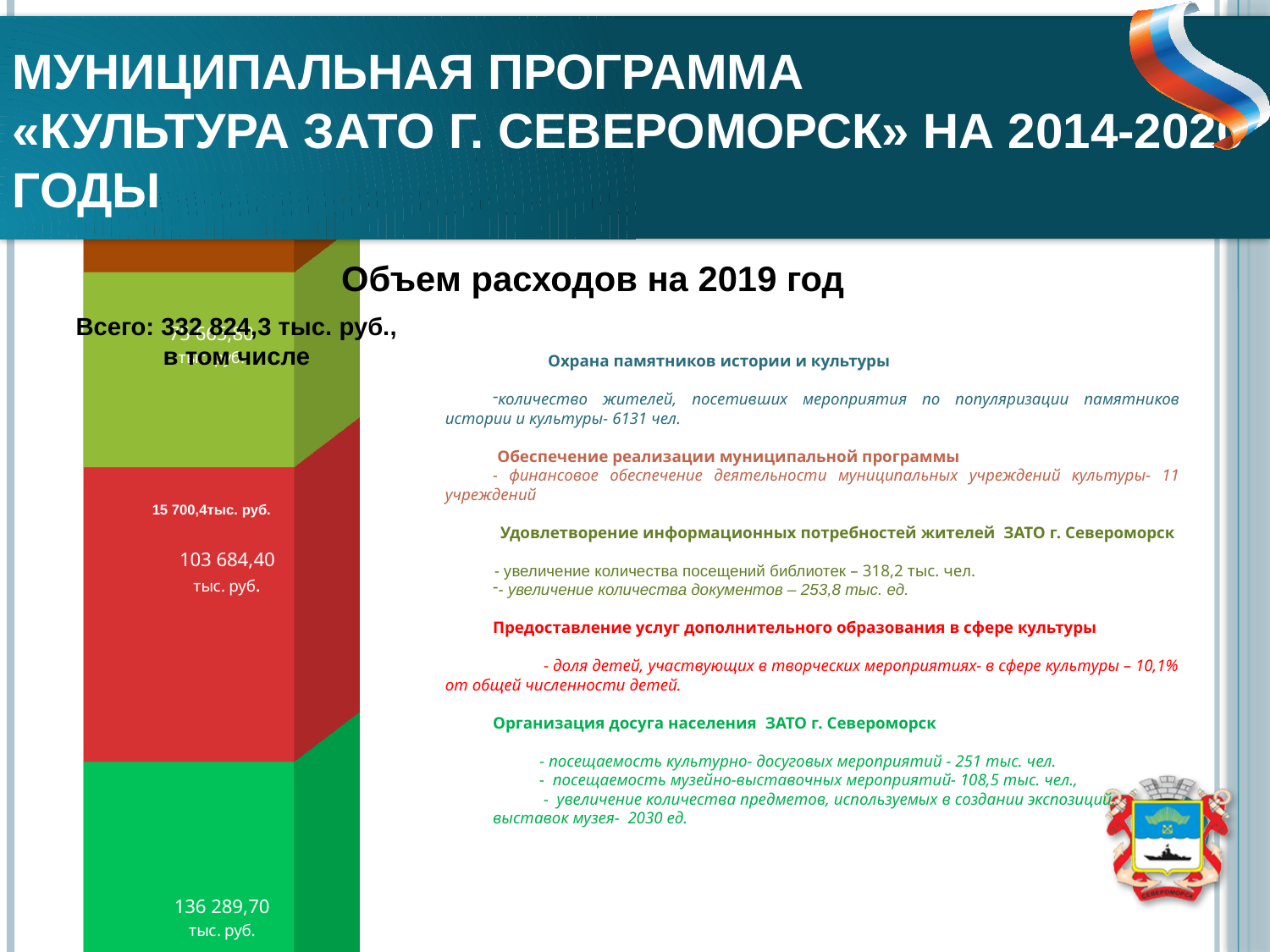
Which segment of the stacked bar is larger: the bottom green segment or the red segment? the bottom green segment What total amount is stated above the chart for 2019? 332 824,3 тыс. руб. How many coloured segments are visible in the stacked bar? 4 Which segment of the stacked bar is the largest? the bottom green segment (136 289,70 тыс. руб.) What is the difference between the bottom green segment (136 289,70) and the red segment (103 684,40) of the stacked bar? 32 605,30 тыс. руб. What value is printed on the red segment of the stacked bar? 103 684,40 тыс. руб. What value is printed on the bottom (green) segment of the stacked bar? 136 289,70 тыс. руб. What kind of chart is shown on the left of the slide? stacked bar chart What is the title of the chart section on the slide? Объем расходов на 2019 год